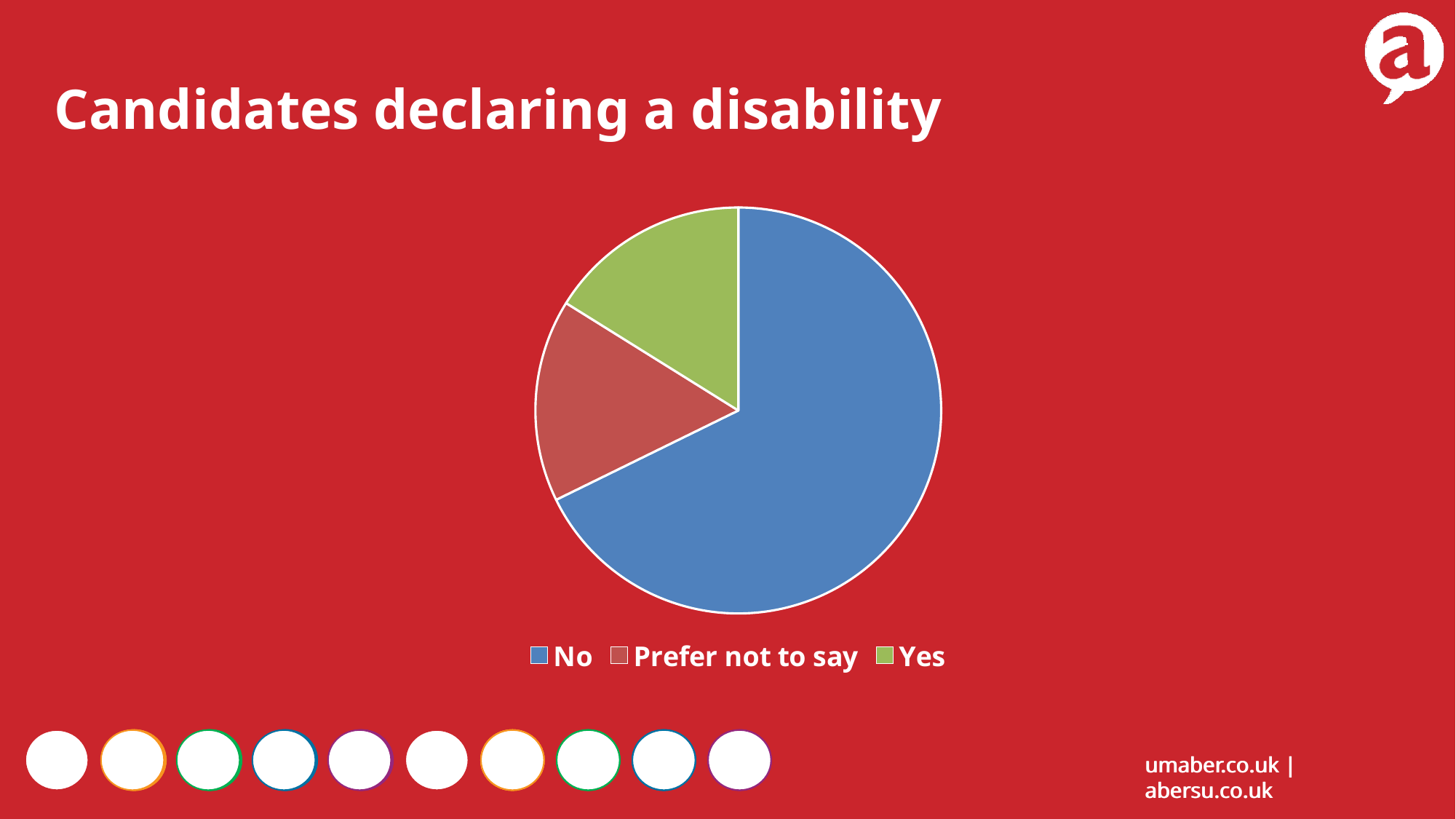
What kind of chart is shown on the slide? pie chart How many categories does the pie chart have? 3 Which slice is larger, No or Yes? No Which category has the largest slice of the pie? No What is the title of the chart? Candidates declaring a disability How many entries does the legend list? 3 What colour is the slice for No? blue Which slice is larger, No or Prefer not to say? No